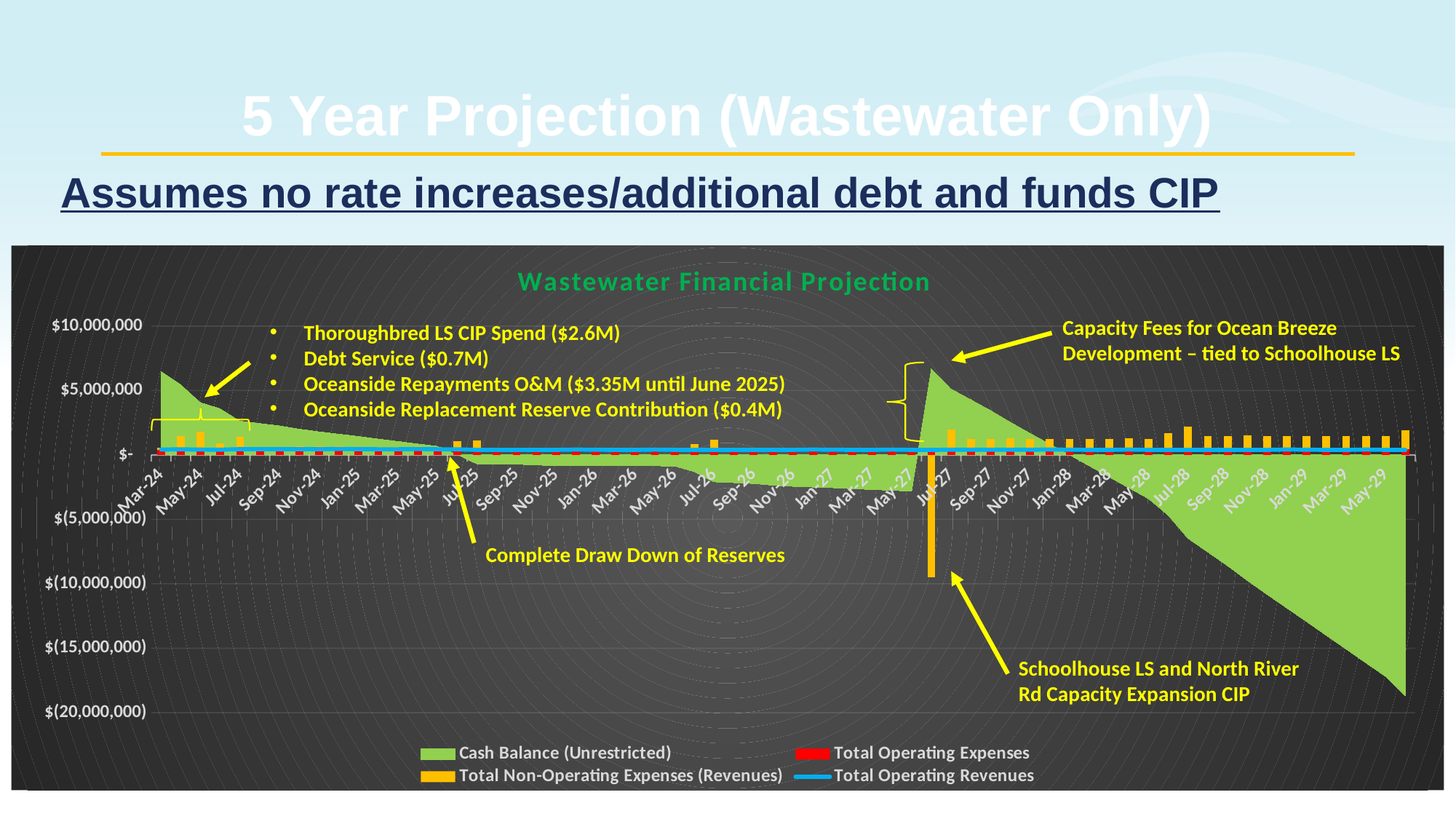
Which colour represents Cash Balance (Unrestricted) in the chart? Green What is the title of the chart? Wastewater Financial Projection Does the Cash Balance (Unrestricted) rise or fall from Jul-27 to May-29? fall Does the Cash Balance (Unrestricted) rise or fall from Mar-24 to May-25? fall How many series does the chart legend list? 4 How many month labels are shown on the x axis? 32 Is the Cash Balance (Unrestricted) at May-29 greater or less than $(15,000,000)? less Is the Cash Balance (Unrestricted) at Mar-24 greater or less than $5,000,000? greater Which is larger, the Cash Balance (Unrestricted) at Mar-24 or at May-29? Mar-24